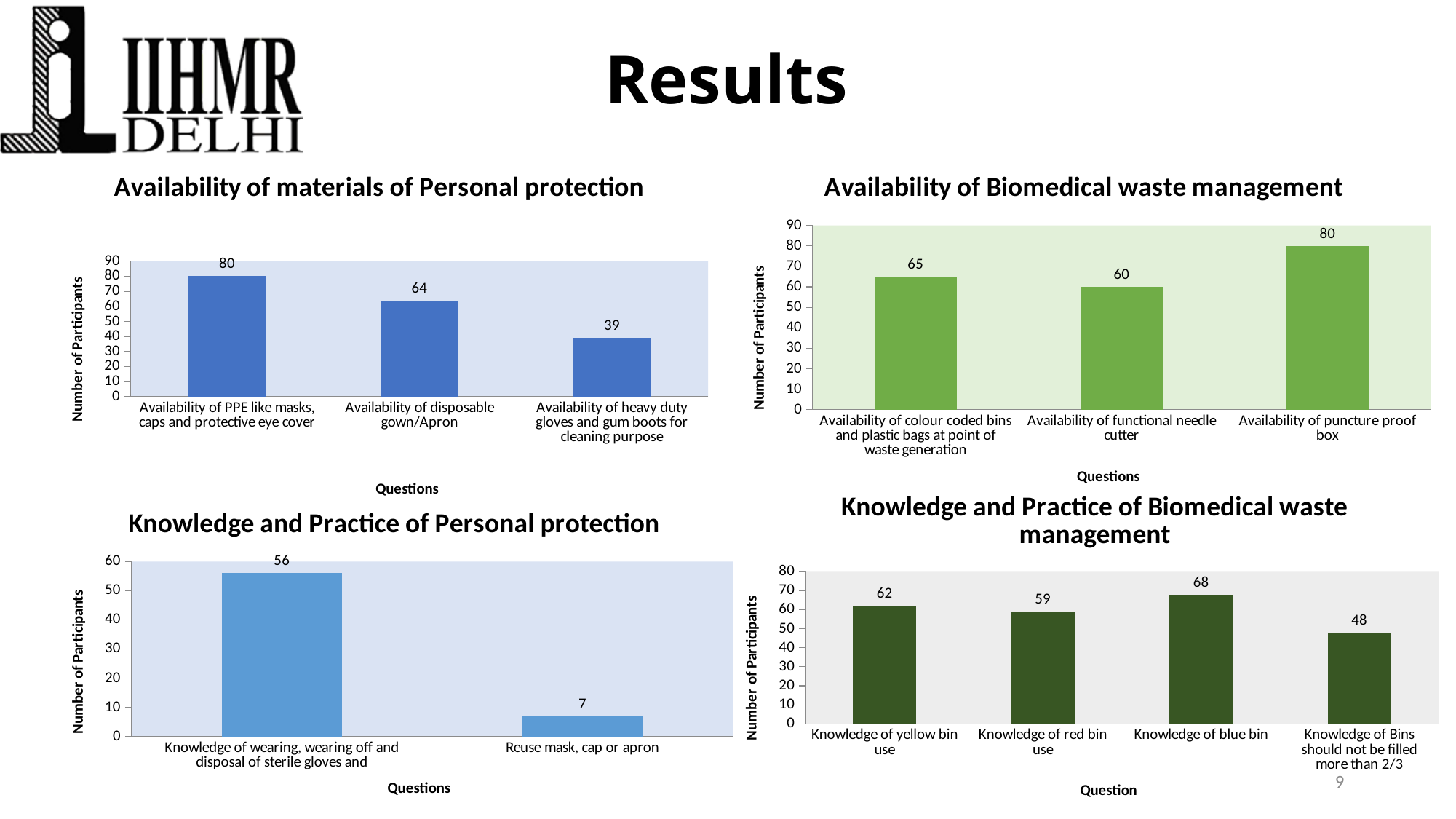
In the 'Availability of Biomedical waste management' chart, which category has the highest value? Availability of puncture proof box In the 'Knowledge and Practice of Biomedical waste management' chart, which is larger: the value for 'Knowledge of yellow bin use' or 'Knowledge of red bin use'? Knowledge of yellow bin use In the 'Knowledge and Practice of Biomedical waste management' chart, what is the value for 'Knowledge of blue bin'? 68 In the 'Availability of materials of Personal protection' chart, what is the difference between the values for PPE like masks, caps and protective eye cover and heavy duty gloves and gum boots? 41 In the 'Knowledge and Practice of Biomedical waste management' chart, which category has the lowest value? Knowledge of Bins should not be filled more than 2/3 In the 'Availability of materials of Personal protection' chart, what is the value for 'Availability of disposable gown/Apron'? 64 In the 'Knowledge and Practice of Personal protection' chart, what is the value for 'Reuse mask, cap or apron'? 7 In the 'Availability of materials of Personal protection' chart, which category has the lowest value? Availability of heavy duty gloves and gum boots for cleaning purpose In the 'Availability of Biomedical waste management' chart, how many categories are shown? 3 In the 'Availability of Biomedical waste management' chart, what is the value for 'Availability of functional needle cutter'? 60 In the 'Knowledge and Practice of Personal protection' chart, what is the difference between the two bars? 49 What kind of chart is the 'Knowledge and Practice of Biomedical waste management' chart? Bar chart